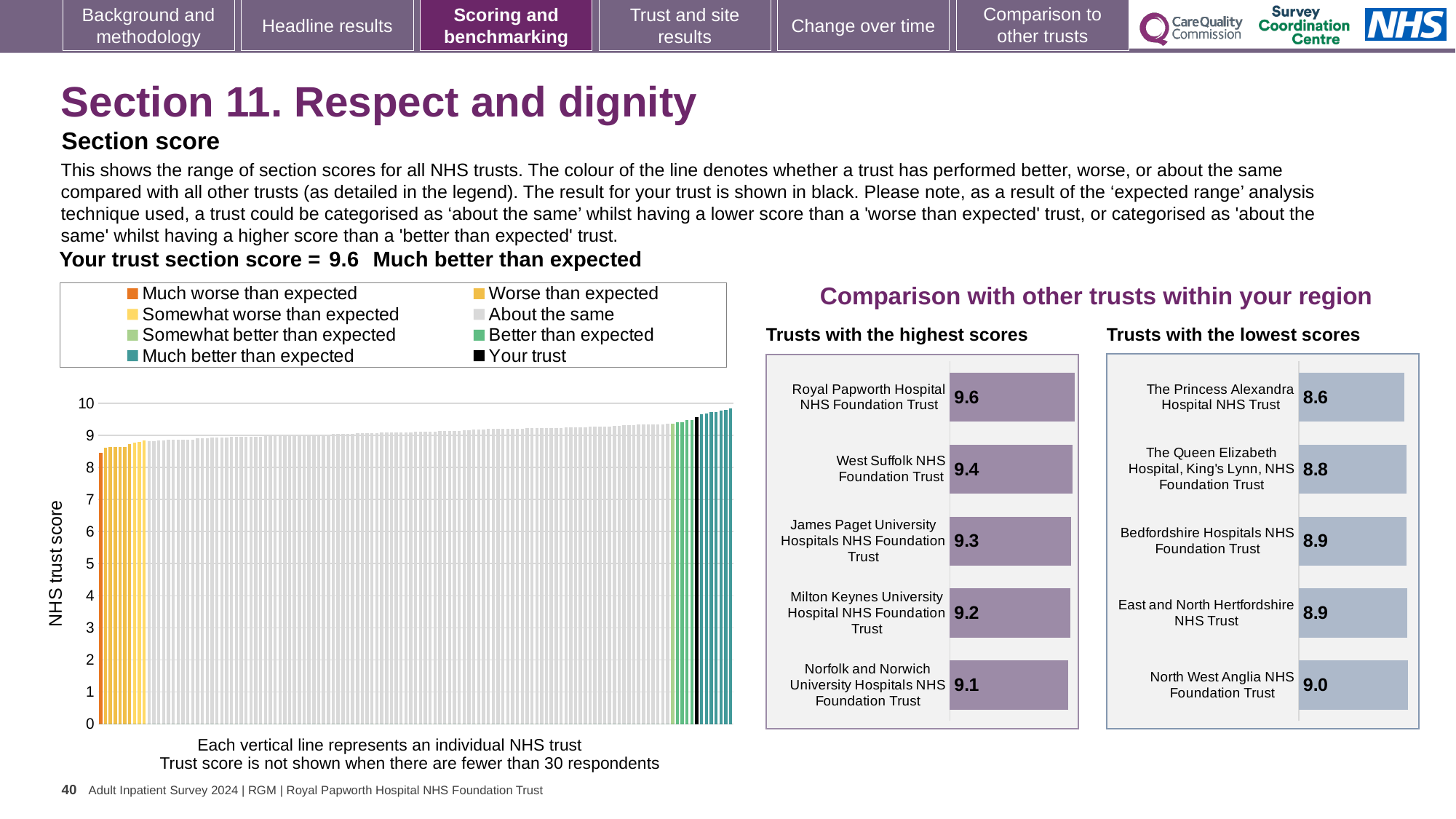
In the 'Trusts with the lowest scores' chart, what is the score for The Princess Alexandra Hospital NHS Trust? 8.6 In the 'Trusts with the lowest scores' chart, what is the difference between the scores of North West Anglia NHS Foundation Trust and The Princess Alexandra Hospital NHS Trust? 0.4 How many trusts are shown in the 'Trusts with the highest scores' chart? 5 What kind of chart is the NHS trust score chart on the left of the slide? Bar chart In the 'Trusts with the highest scores' chart, which trust has the highest score? Royal Papworth Hospital NHS Foundation Trust In the 'Trusts with the lowest scores' chart, which trust has the lowest score? The Princess Alexandra Hospital NHS Trust In the NHS trust score chart on the left, do the trust scores rise or fall from left to right? Rise In the 'Trusts with the lowest scores' chart, what is the score for North West Anglia NHS Foundation Trust? 9.0 How many entries does the legend of the NHS trust score chart on the left list? 8 In the 'Trusts with the highest scores' chart, which has the higher score: West Suffolk NHS Foundation Trust or James Paget University Hospitals NHS Foundation Trust? West Suffolk NHS Foundation Trust In the 'Trusts with the highest scores' chart, what is the difference between the scores of Royal Papworth Hospital NHS Foundation Trust and Norfolk and Norwich University Hospitals NHS Foundation Trust? 0.5 In the 'Trusts with the highest scores' chart, what is the score for Royal Papworth Hospital NHS Foundation Trust? 9.6